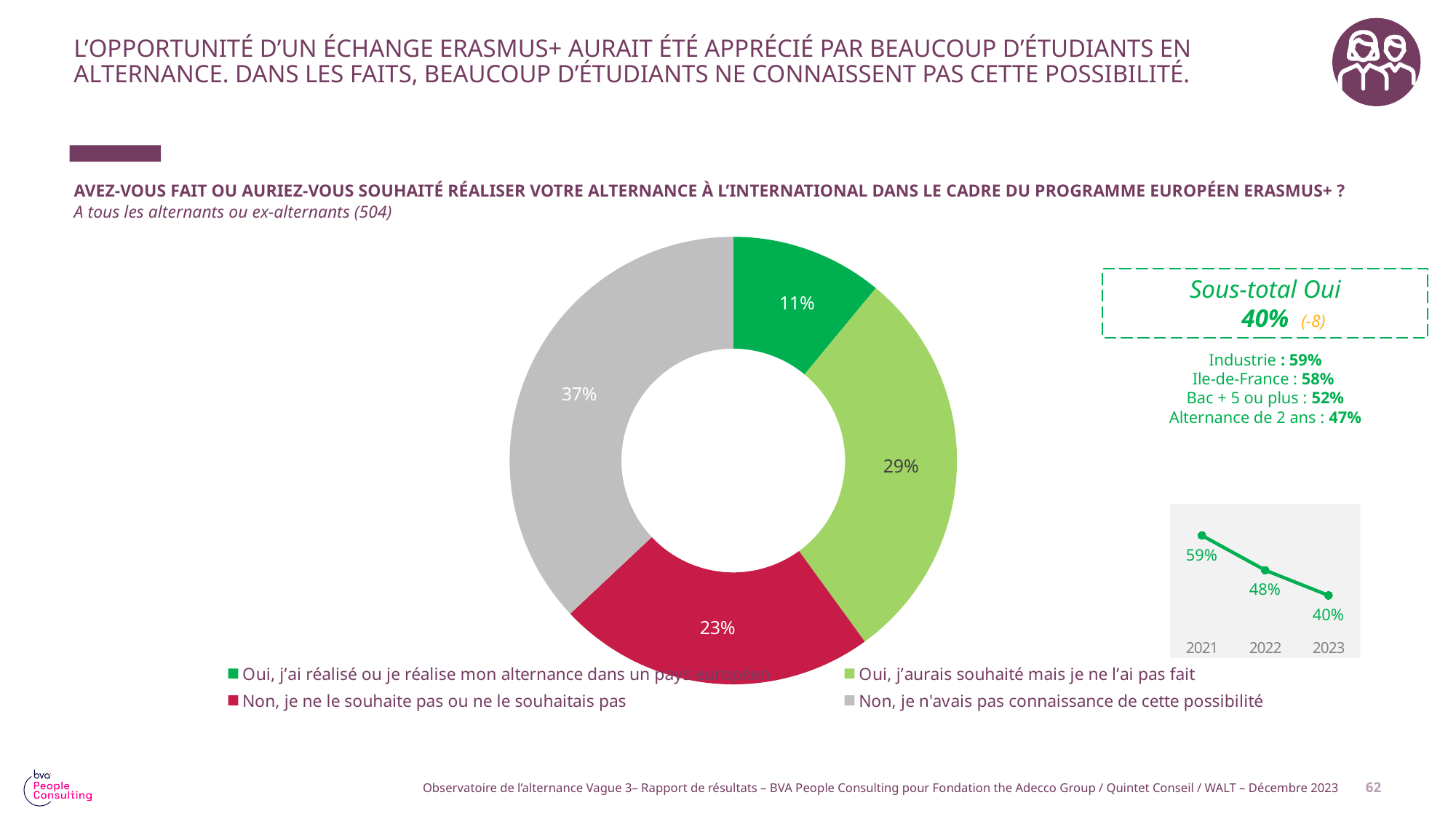
On the small line chart at the right, what is the difference between the 2021 and 2023 values? 19 points How many response categories does the donut chart's legend list? 4 On the donut chart, what percentage of respondents answered "Non, je n'avais pas connaissance de cette possibilité"? 37% On the small line chart at the right, what is the value for 2022? 48% On the donut chart, what percentage answered "Oui, j'aurais souhaité mais je ne l'ai pas fait"? 29% On the donut chart, which is larger: "Oui, j'aurais souhaité mais je ne l'ai pas fait" or "Non, je ne le souhaite pas ou ne le souhaitais pas"? Oui, j'aurais souhaité mais je ne l'ai pas fait On the small line chart at the right, do the values rise or fall from 2021 to 2023? Fall On the donut chart, which response has the largest share? Non, je n'avais pas connaissance de cette possibilité On the donut chart, which response has the smallest share? Oui, j'ai réalisé ou je réalise mon alternance dans un pays européen On the donut chart, what is the difference in percentage points between "Non, je n'avais pas connaissance de cette possibilité" and "Non, je ne le souhaite pas ou ne le souhaitais pas"? 14 points What type of chart is the main chart on the slide? Donut (pie) chart On the donut chart, what percentage answered "Oui, j'ai réalisé ou je réalise mon alternance dans un pays européen"? 11%